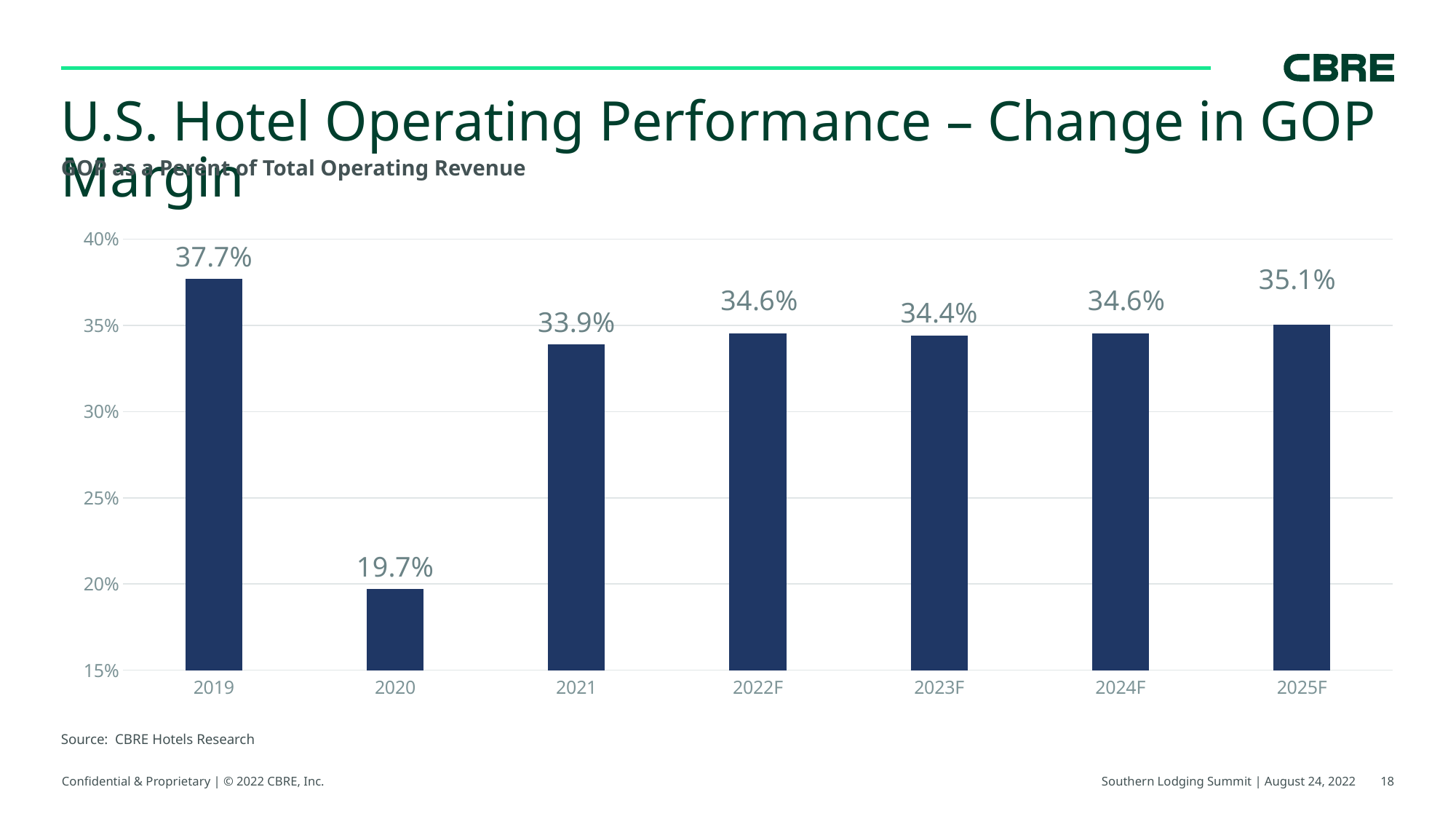
Which is larger, the value for 2021 or the value for 2025F? 2025F What is the subtitle of the chart? GOP as a Percent of Total Operating Revenue How many years are shown on the x axis? 7 What is the GOP margin value shown for 2020? 19.7% What kind of chart is shown on the slide? Bar chart What is the value shown for 2023F? 34.4% What is the GOP margin value shown for 2019? 37.7% Which year has the highest GOP margin? 2019 What is the value shown for 2025F? 35.1% What is the difference between the 2019 value and the 2020 value? 18.0% Which year has the lowest GOP margin? 2020 What is the difference between the 2025F value and the 2021 value? 1.2%